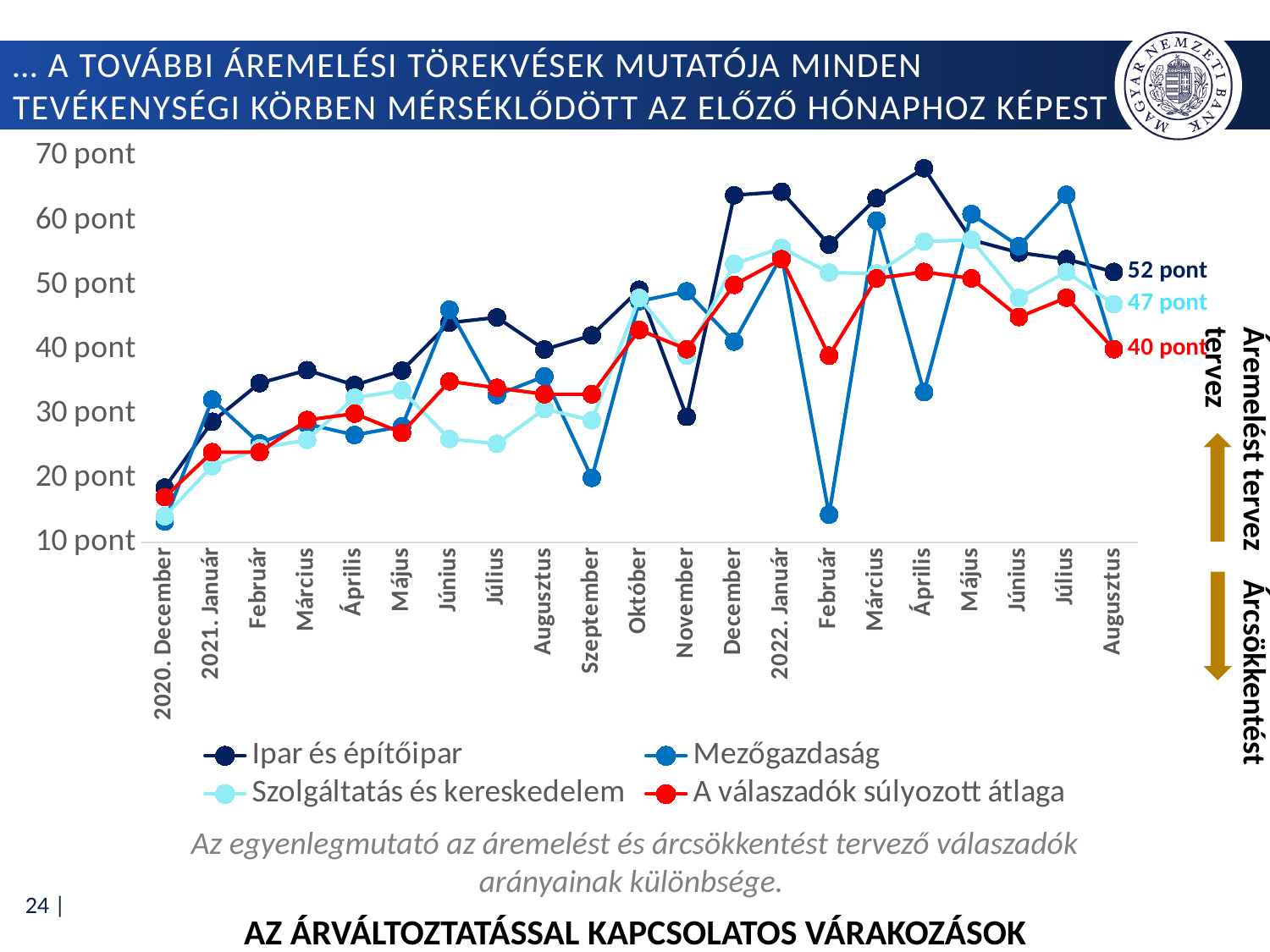
Does the Ipar és építőipar series overall rise or fall from 2020 December to Augusztus 2022? rise What is the value of the Ipar és építőipar series in Augusztus 2022? 52 pont What is the difference between the Ipar és építőipar value and the Szolgáltatás és kereskedelem value in Augusztus 2022? 5 pont How many series does the legend list? 4 In Augusztus 2022, which is larger: Ipar és építőipar or Szolgáltatás és kereskedelem? Ipar és építőipar What is the value of A válaszadók súlyozott átlaga in Augusztus 2022? 40 pont In which month does the Ipar és építőipar series reach its highest value? 2022 Április What kind of chart is shown on the slide? line chart How many months (data points) are shown along the x axis? 21 What is the difference between the Ipar és építőipar value and A válaszadók súlyozott átlaga value in Augusztus 2022? 12 pont What is the value of the Szolgáltatás és kereskedelem series in Augusztus 2022? 47 pont Is the value for Mezőgazdaság in 2022 Február greater or less than 20 pont? less